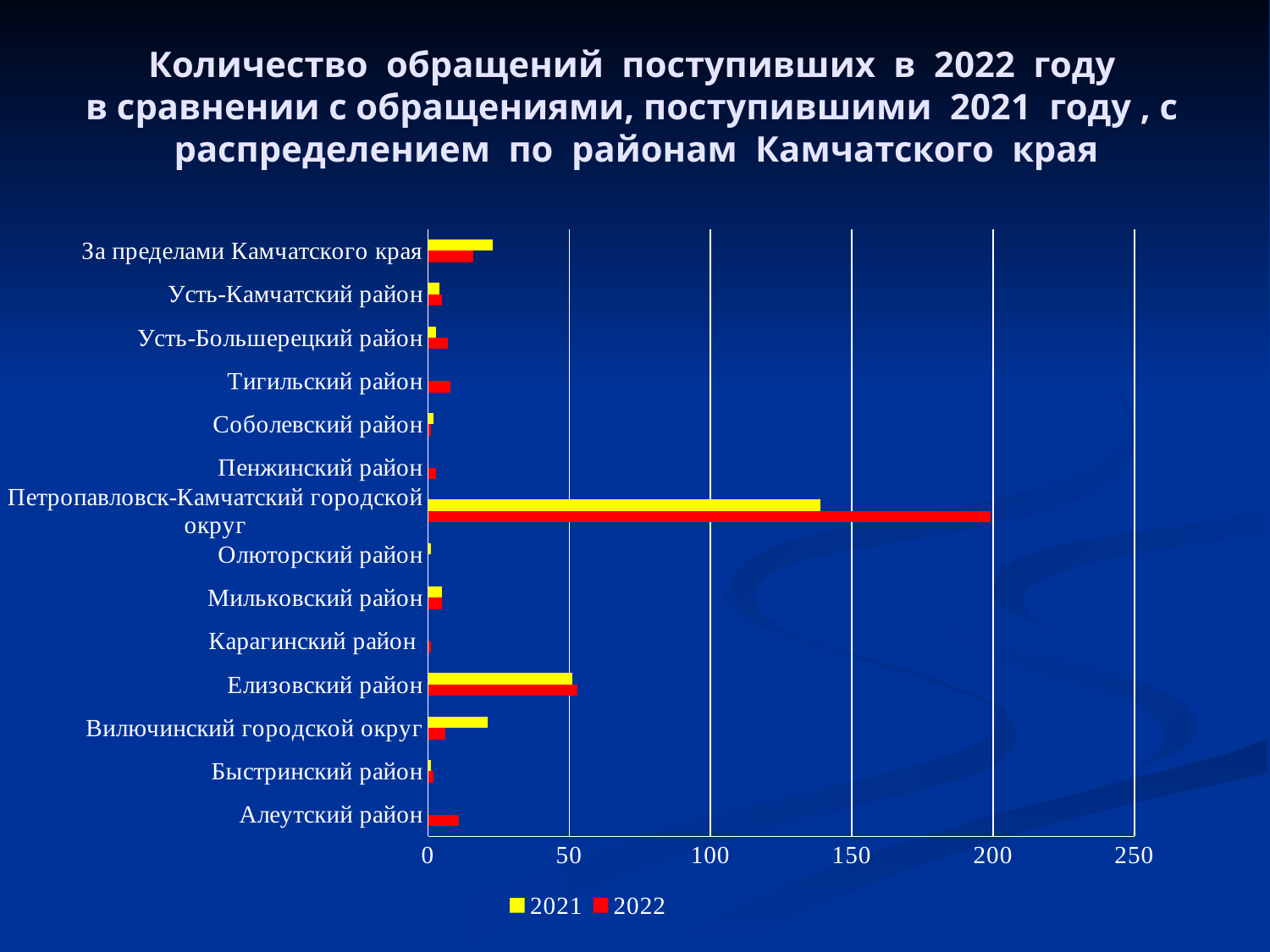
For Петропавловск-Камчатский городской округ, which year has the larger value, 2021 or 2022? 2022 Which district has the highest value for 2022? Петропавловск-Камчатский городской округ Which series is shown in red? 2022 How many series does the legend list? 2 Which series is shown in yellow? 2021 What kind of chart is shown on the slide? bar chart For Вилючинский городской округ, which year has the larger value, 2021 or 2022? 2021 Is the 2021 value for Петропавловск-Камчатский городской округ greater or less than 150? less Is the 2022 value for Елизовский район greater or less than 100? less Is the 2022 value for Петропавловск-Камчатский городской округ greater or less than 150? greater How many districts (categories) are shown on the chart? 14 Which district has the highest value for 2021? Петропавловск-Камчатский городской округ